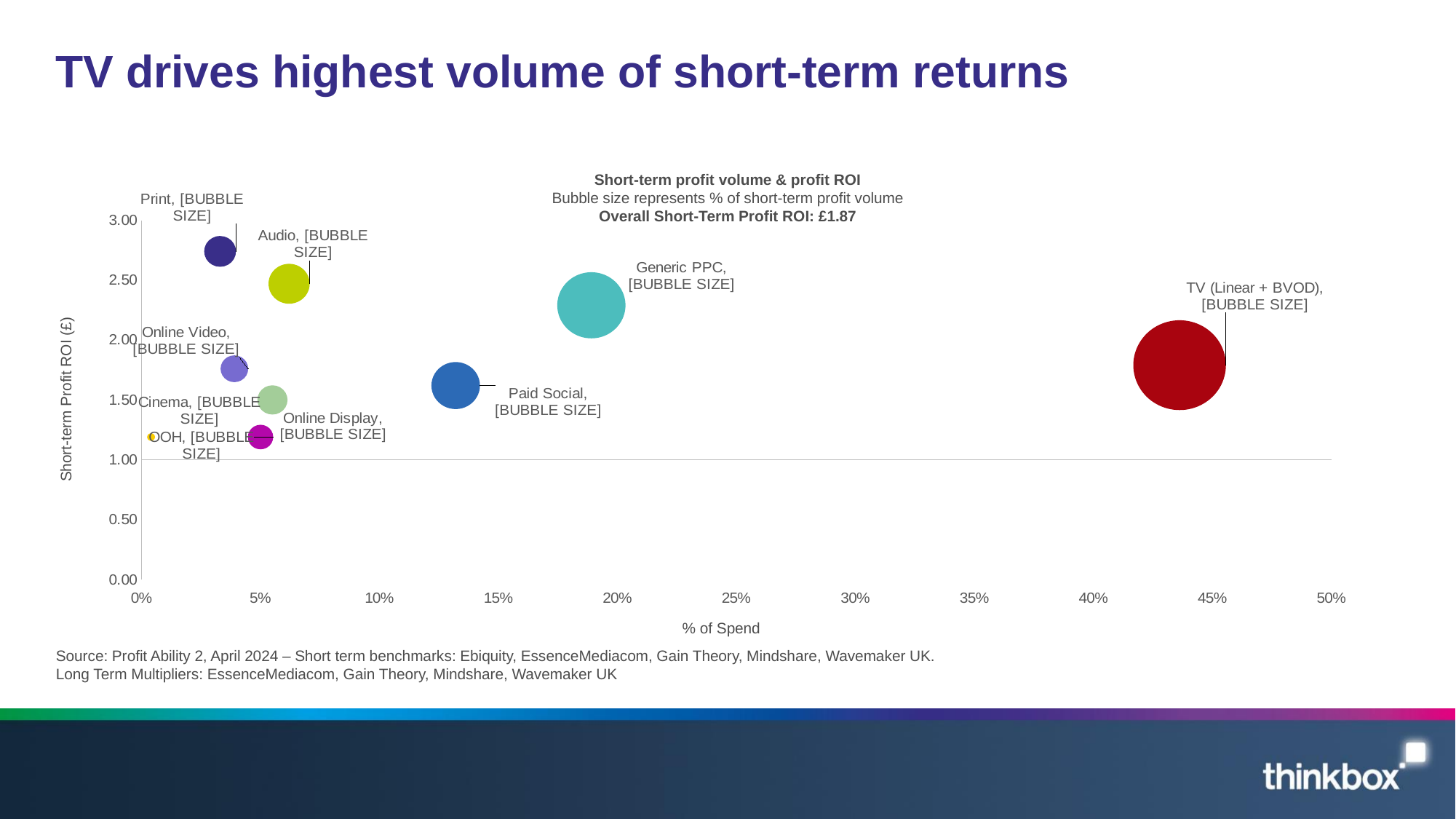
Is the short-term profit ROI for Generic PPC greater or less than 2.00? greater Which media channel has the lowest % of spend on the chart? OOH How many bubbles (media channels) are plotted on the chart? 9 Which media channel has the highest short-term profit ROI on the chart? Print What kind of chart is shown on the slide? Bubble chart Which media channel has the highest % of spend on the chart? TV (Linear + BVOD) Which media channel has the largest bubble on the chart? TV (Linear + BVOD) Is the short-term profit ROI for TV (Linear + BVOD) greater or less than 2.00? less Is the % of spend for Paid Social greater or less than 10%? greater What is the Overall Short-Term Profit ROI stated on the chart? £1.87 Which has the higher short-term profit ROI, Generic PPC or TV (Linear + BVOD)? Generic PPC